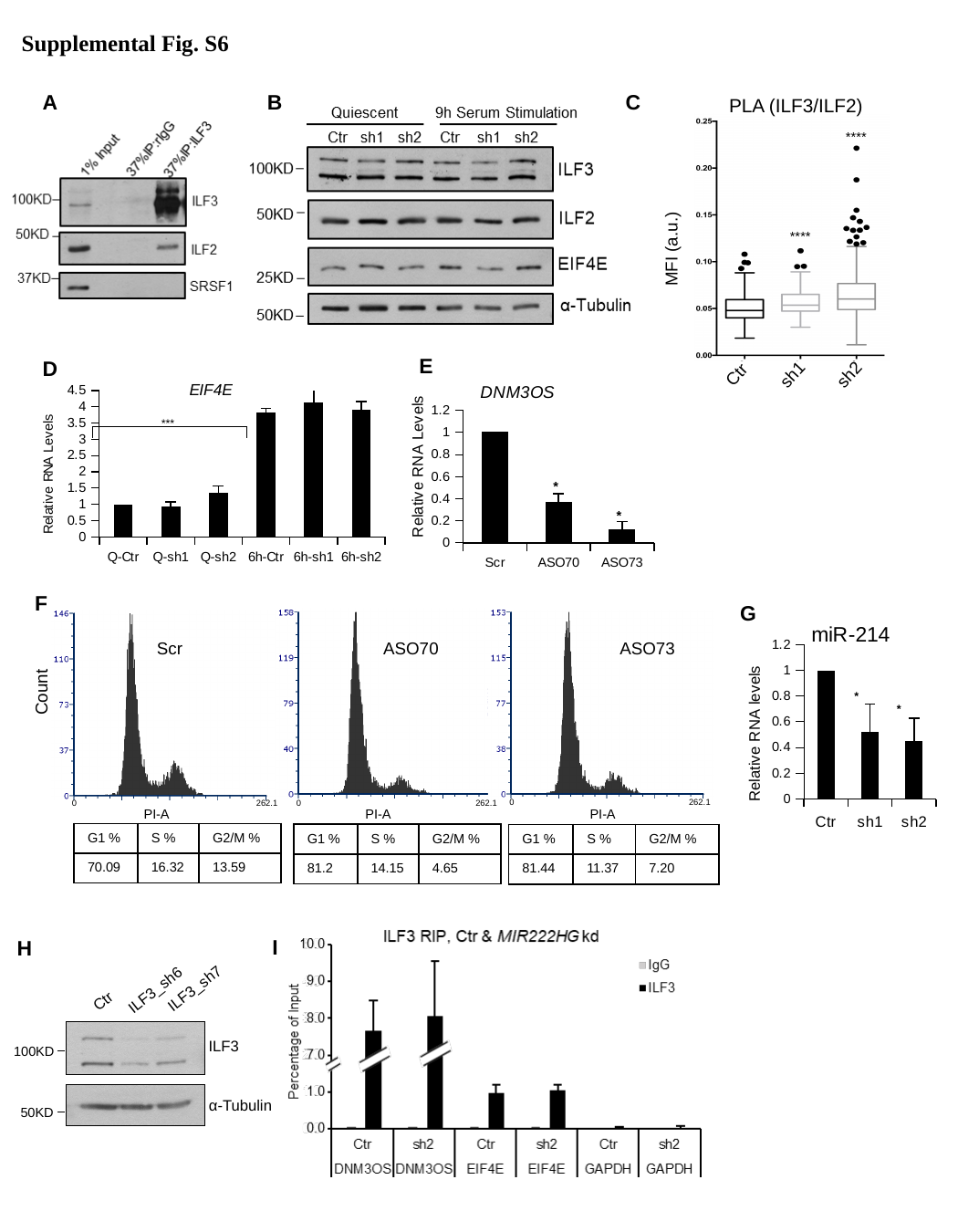
In chart D (EIF4E), which is larger, the value for Q-sh2 or the value for 6h-sh2? 6h-sh2 In chart G (miR-214), which category has the highest relative RNA level? Ctr In panel F, what is the G1 % for the Scr sample? 70.09 In chart E (DNM3OS), is the value for ASO70 greater or less than 0.6? less In chart D (EIF4E), how many categories are shown on the x axis? 6 In panel F, what is the S % for the ASO70 sample? 14.15 In chart G (miR-214), is the value for sh1 greater or less than 0.8? less In chart I (ILF3 RIP), is the ILF3 value for Ctr DNM3OS greater or less than 7.0? greater In chart E (DNM3OS), which category has the lowest relative RNA level? ASO73 In chart I (ILF3 RIP), how many series does the legend list? 2 In panel F, what is the difference in G1 % between ASO70 and Scr? 11.11